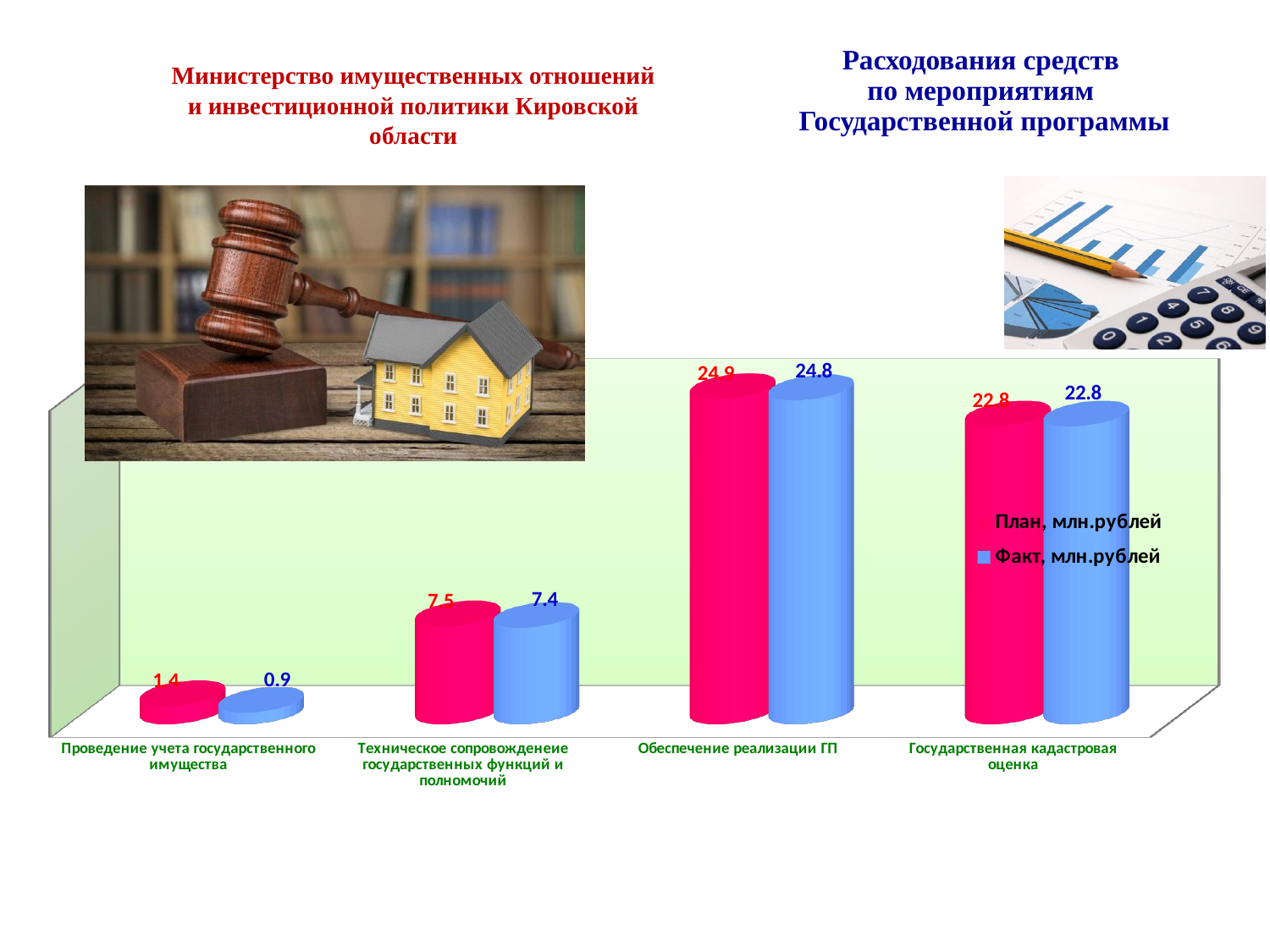
How many series does the chart legend list? 2 What is the План value for Государственная кадастровая оценка? 22.8 What type of chart is shown on the slide? Bar chart Which category has the lowest План value? Проведение учета государственного имущества How many categories are shown on the x axis of the chart? 4 What is the План value for Обеспечение реализации ГП? 24.9 Which is larger: the Факт value for Техническое сопровождение государственных функций и полномочий or the Факт value for Государственная кадастровая оценка? Государственная кадастровая оценка What is the difference between the План and Факт values for Проведение учета государственного имущества? 0.5 What is the difference between the План values for Обеспечение реализации ГП and Государственная кадастровая оценка? 2.1 Which category has the highest Факт value? Обеспечение реализации ГП What is the Факт value for Техническое сопровождение государственных функций и полномочий? 7.4 What is the Факт value for Проведение учета государственного имущества? 0.9